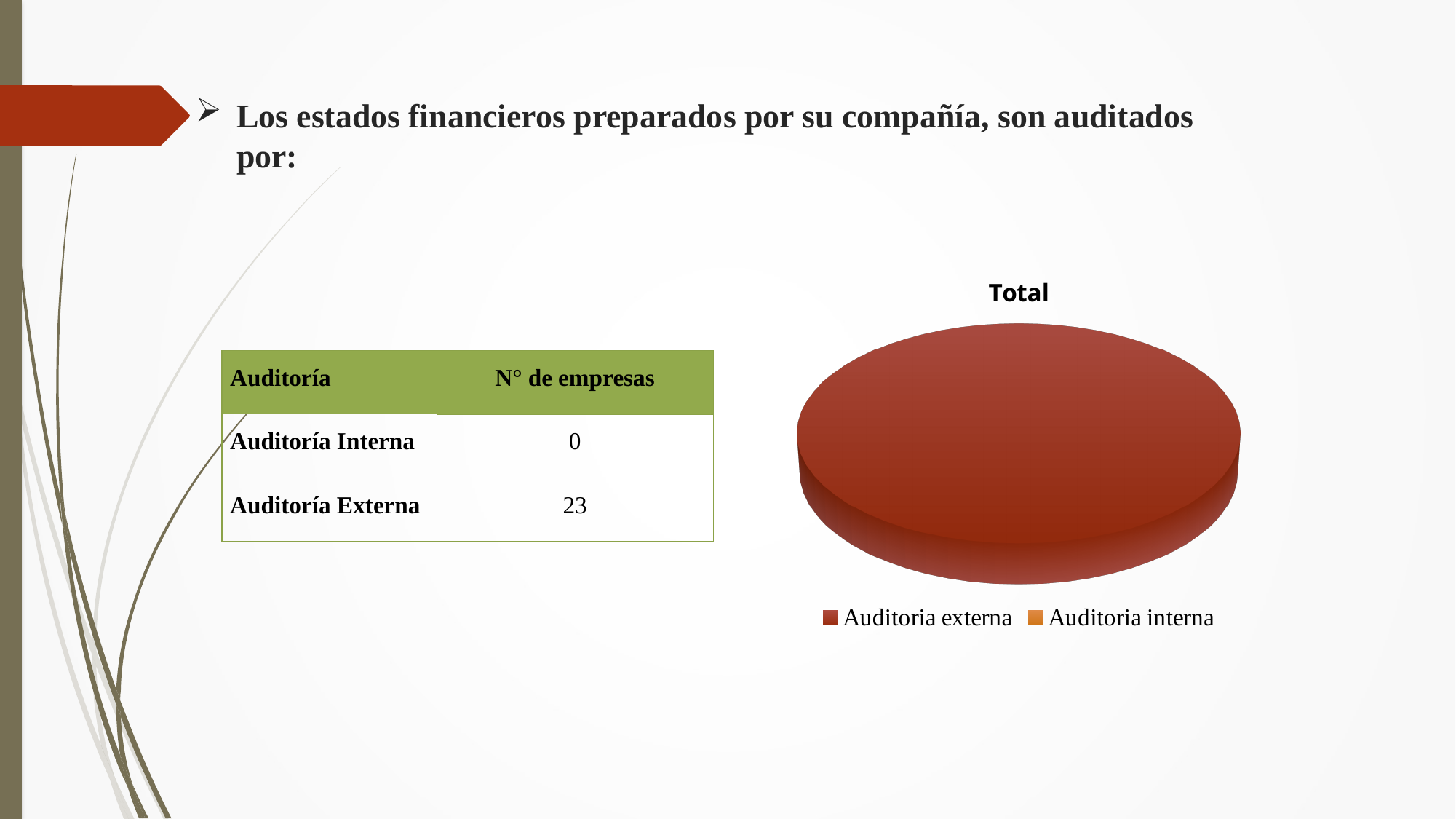
What is the title of the pie chart? Total What is the difference between the number of companies with Auditoría Externa and Auditoría Interna? 23 How many entries does the legend of the pie chart list? 2 Which category has the lowest number of companies? Auditoría Interna What kind of chart is shown on the slide? pie chart Which category has the highest number of companies? Auditoría Externa According to the table next to the pie chart, how many companies use Auditoría Interna? 0 What share of the pie chart does Auditoria externa represent? 100% What is the total number of companies across both audit categories? 23 Which legend entry of the pie chart is shown in red? Auditoria externa Which is larger, the number of companies with Auditoría Externa or with Auditoría Interna? Auditoría Externa According to the table next to the pie chart, how many companies use Auditoría Externa? 23